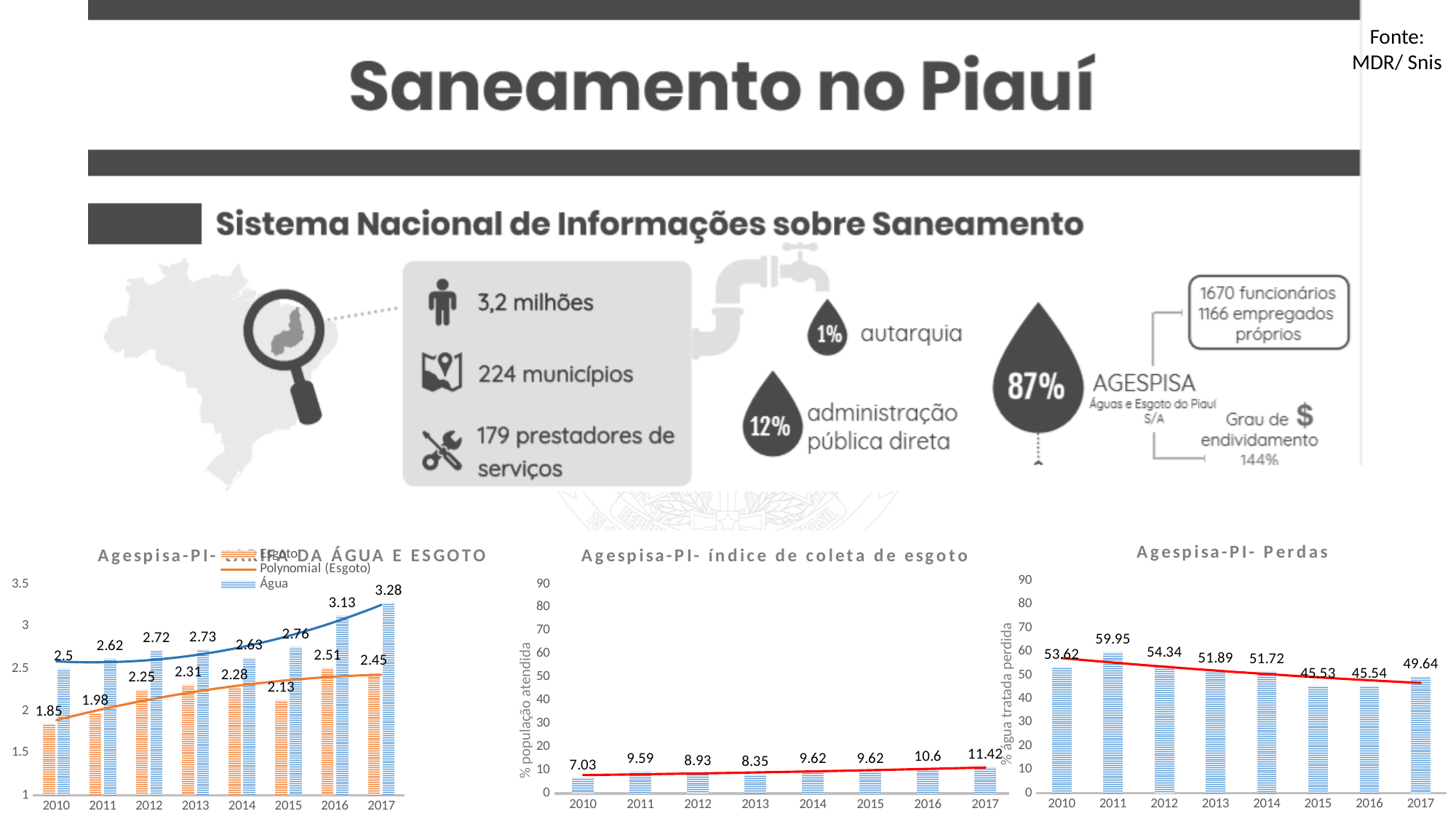
In the left chart (tariff of water and sewage), what is the Água value for 2017? 3.28 What kind of chart is the 'Agespisa-PI- Perdas' chart? Bar chart In the 'Agespisa-PI- índice de coleta de esgoto' chart, what is the value for 2017? 11.42 In the 'Agespisa-PI- Perdas' chart, which year has the lowest value? 2015 In the 'Agespisa-PI- índice de coleta de esgoto' chart, is the value for 2016 greater or less than 20? less In the 'Agespisa-PI- Perdas' chart, what is the value for 2011? 59.95 In the 'Agespisa-PI- Perdas' chart, what is the difference between the 2011 value and the 2017 value? 10.31 In the left chart (tariff of water and sewage), what is the Esgoto value for 2010? 1.85 In the 'Agespisa-PI- índice de coleta de esgoto' chart, which year has the lowest value? 2010 In the 'Agespisa-PI- índice de coleta de esgoto' chart, how many years are shown on the x axis? 8 In the left chart (tariff of water and sewage), what is the difference between the Água and Esgoto values in 2017? 0.83 In the left chart (tariff of water and sewage), which is larger in 2016: the Água value or the Esgoto value? Água